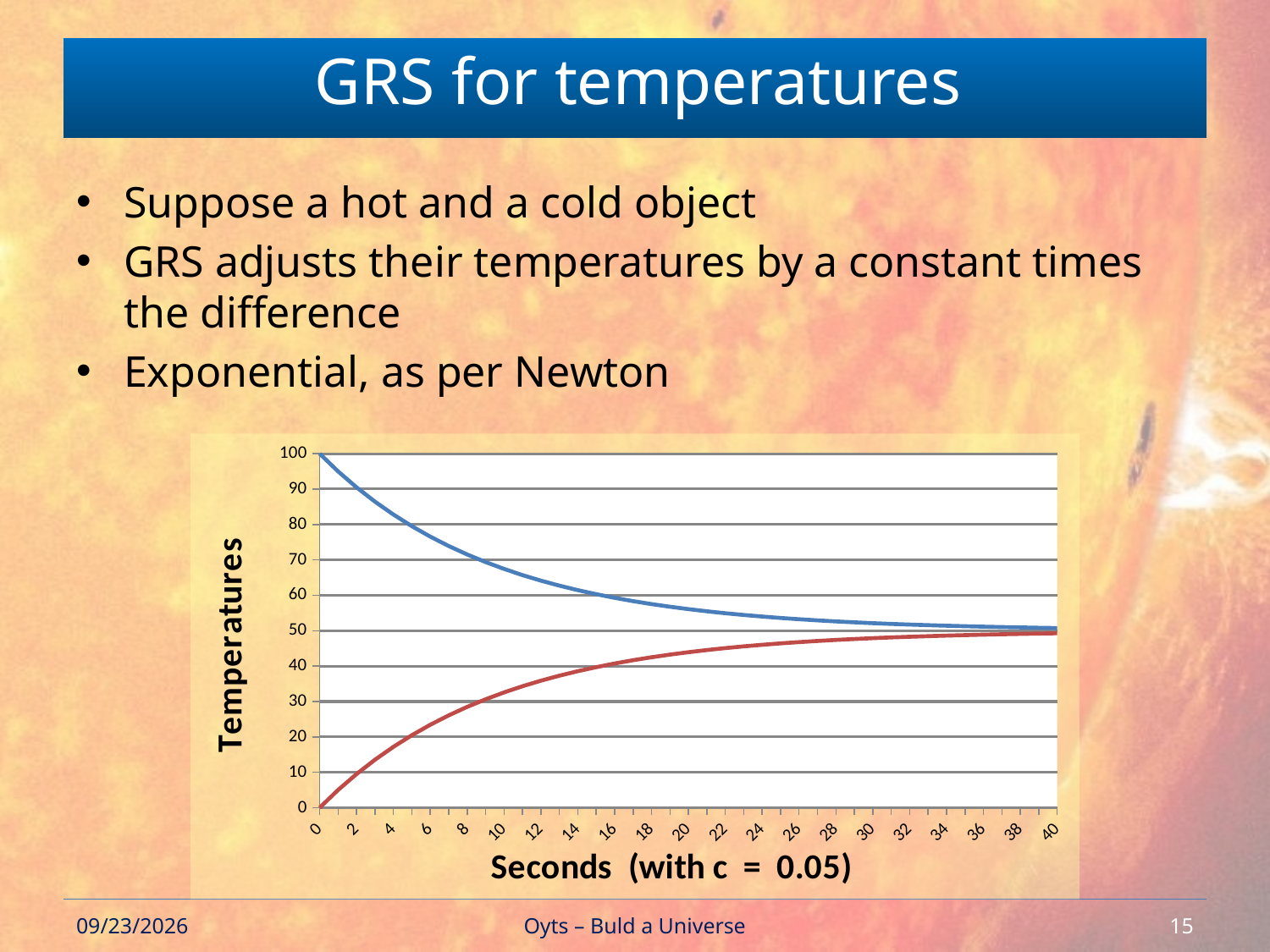
Is the value of the blue line at 40 seconds greater or less than 60? less What is the title of the y axis? Temperatures Is the value of the blue line at 10 seconds greater or less than 60? greater What kind of chart is shown on the slide? line chart Does the red line rise or fall as seconds increase? rise What is the value of the red line at 0 seconds? 0 Does the blue line rise or fall as seconds increase? fall What is the title of the x axis? Seconds (with c = 0.05) At 4 seconds, which line has the higher value, the blue line or the red line? the blue line Is the value of the red line at 10 seconds greater or less than 40? less What is the value of the blue line at 0 seconds? 100 How many lines are plotted on the chart? 2